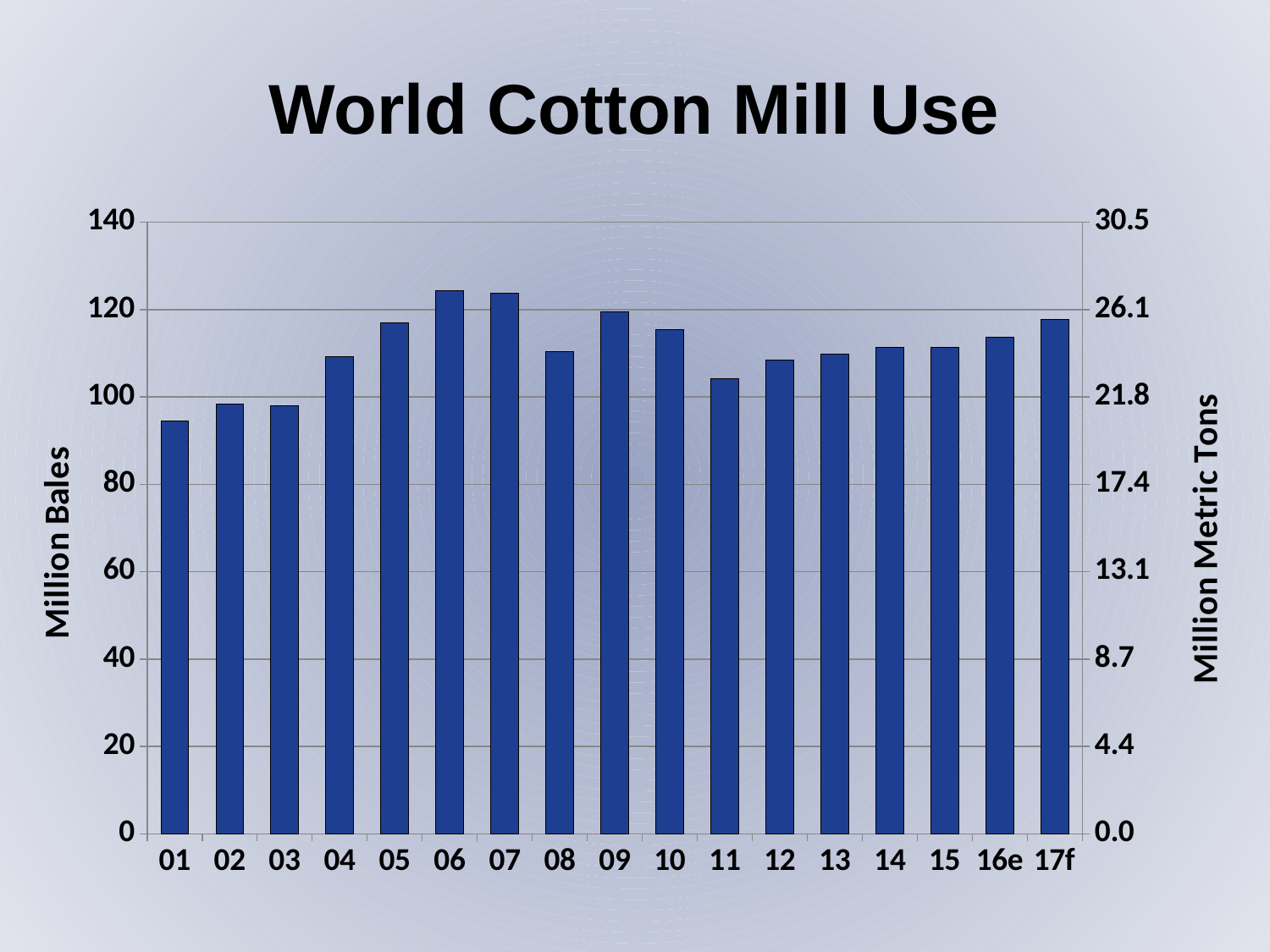
Is the value for 11 greater or less than 100 million bales? greater Which is larger, the value for 09 or the value for 10? 09 Which year has the lowest world cotton mill use? 01 What is the title of the chart? World Cotton Mill Use How many years (categories) are plotted on the x axis? 17 What is the label of the left vertical axis? Million Bales Is the value for 05 greater or less than 120 million bales? less Is the value for 01 greater or less than 100 million bales? less Do the values rise or fall from 01 to 06? rise Which is larger, the value for 05 or the value for 11? 05 What kind of chart is shown on the slide? bar chart